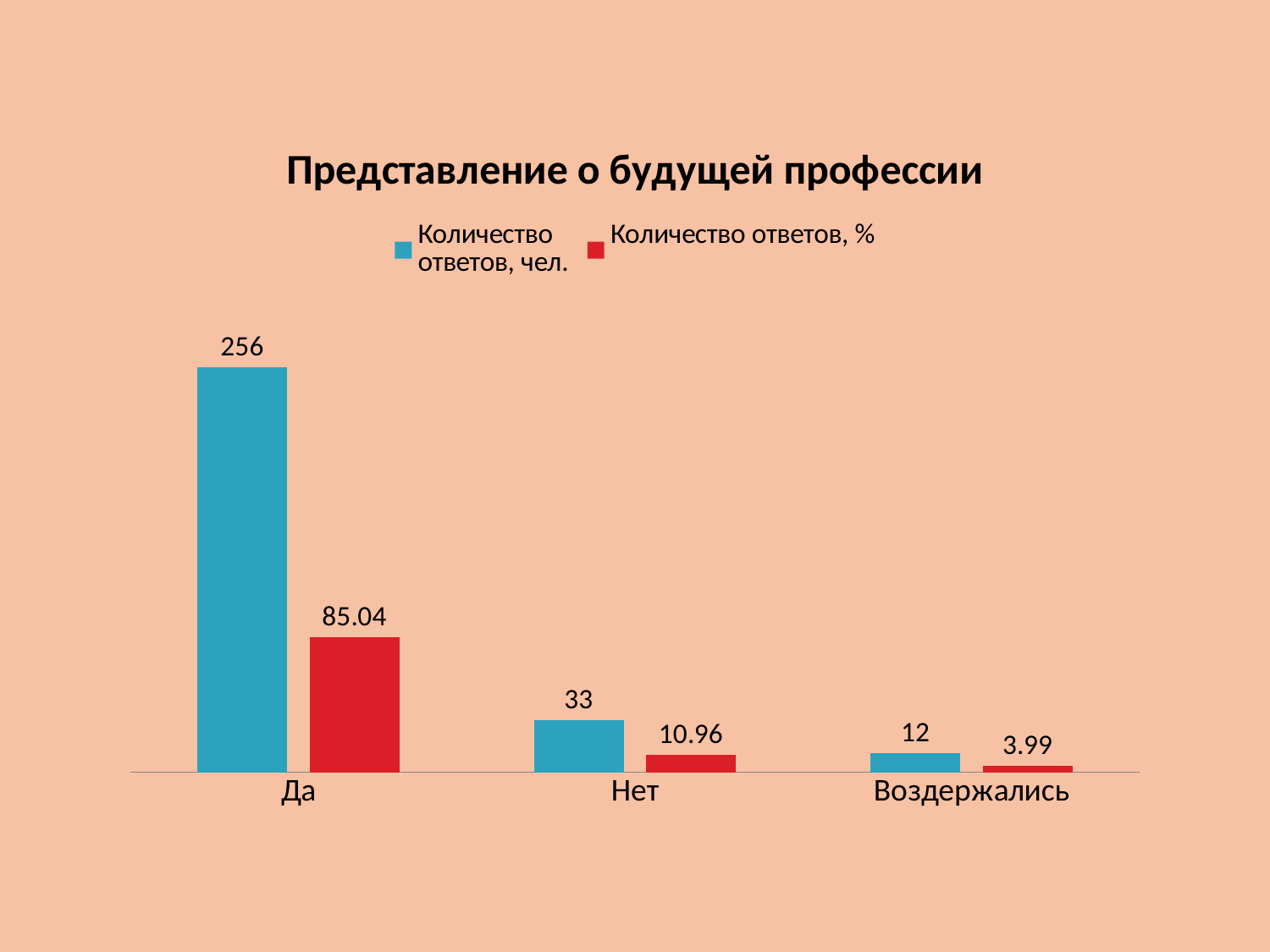
What is the value of "Количество ответов, чел." for "Да"? 256 What is the value of "Количество ответов, %" for "Нет"? 10.96 Which is larger: the "Количество ответов, чел." value for "Нет" or for "Воздержались"? Нет How many categories are shown on the x axis? 3 Which category has the highest value for "Количество ответов, чел."? Да Which category has the lowest value for "Количество ответов, %"? Воздержались What is the difference between the "Количество ответов, чел." values for "Да" and "Нет"? 223 What is the value of "Количество ответов, %" for "Воздержались"? 3.99 What is the value of "Количество ответов, чел." for "Воздержались"? 12 What kind of chart is shown on the slide? Bar chart How many series does the legend list? 2 What is the title of the chart? Представление о будущей профессии